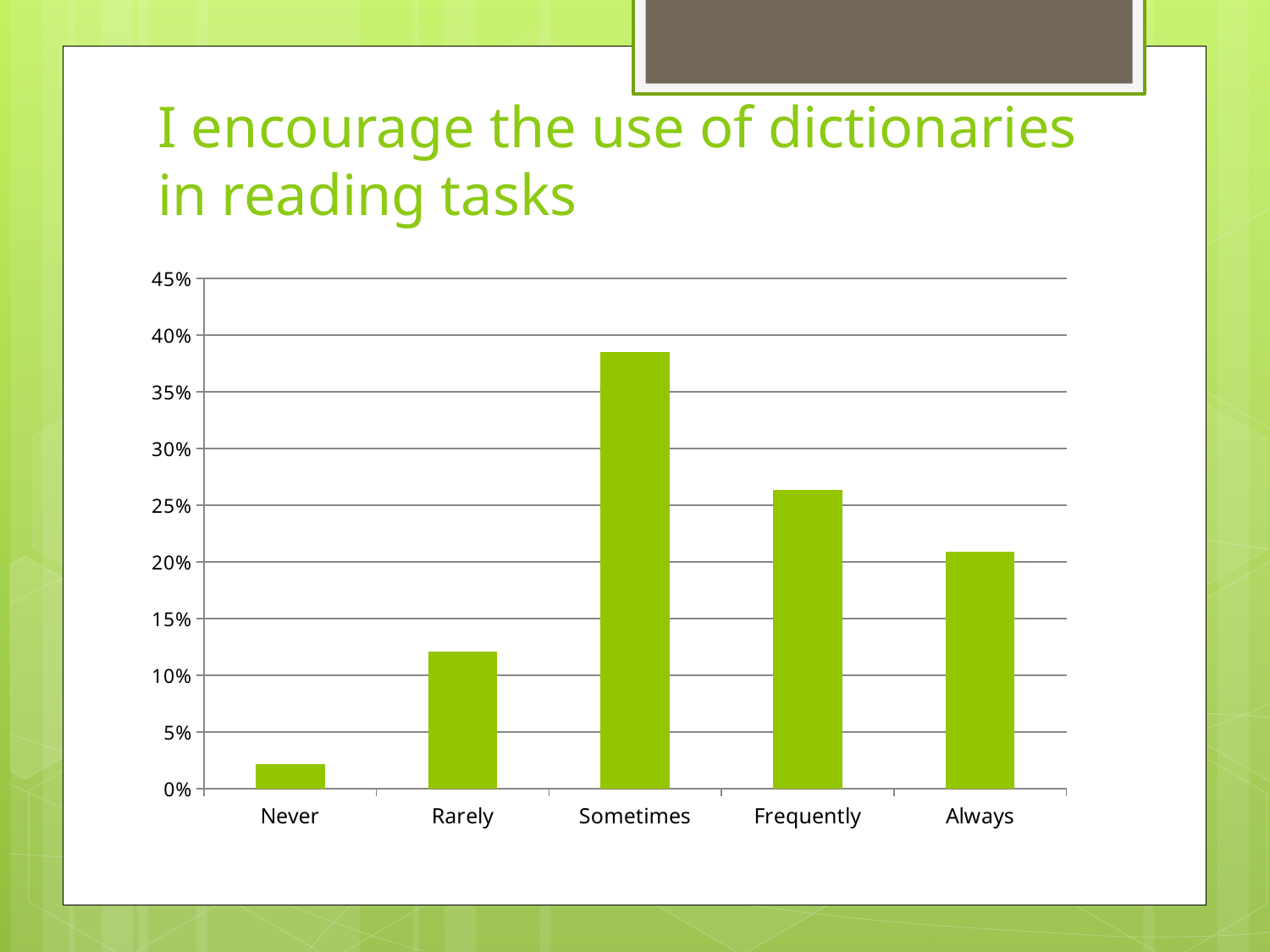
Is the value for Sometimes greater or less than 40%? less How many categories are shown on the x axis of the chart? 5 Is the value for Rarely greater or less than 10%? greater What kind of chart is shown on the slide? bar chart Which category has the lowest value in the chart? Never What is the title of the slide containing the chart? I encourage the use of dictionaries in reading tasks Is the value for Never greater or less than 5%? less Which category has the highest value in the chart? Sometimes Which is larger, the value for Frequently or the value for Always? Frequently